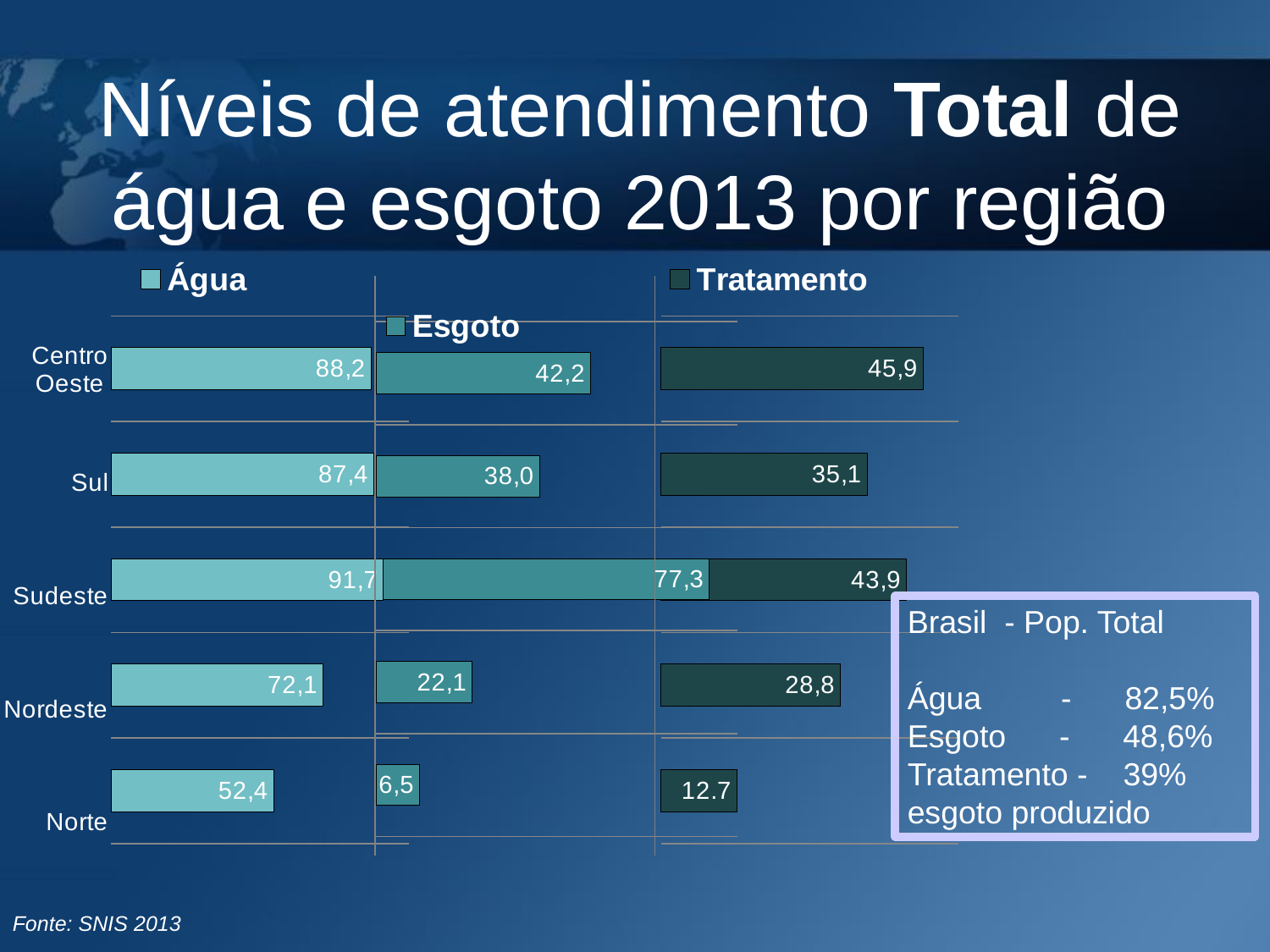
Which region has the highest Esgoto value? Sudeste What is the difference between the Água values for Centro Oeste and Sul? 0,8 What is the Esgoto value for Centro Oeste? 42,2 Which is larger, the Tratamento value for Centro Oeste or for Sudeste? Centro Oeste What is the difference between the Esgoto and Tratamento values for Sul? 2,9 How many regions are shown in the chart? 5 What is the Tratamento value for Norte? 12.7 What kind of chart is shown on the slide? Bar chart How many series does the legend list? 3 What is the Água value for Sudeste? 91,7 Which region has the lowest Água value? Norte What is the Esgoto value for Nordeste? 22,1